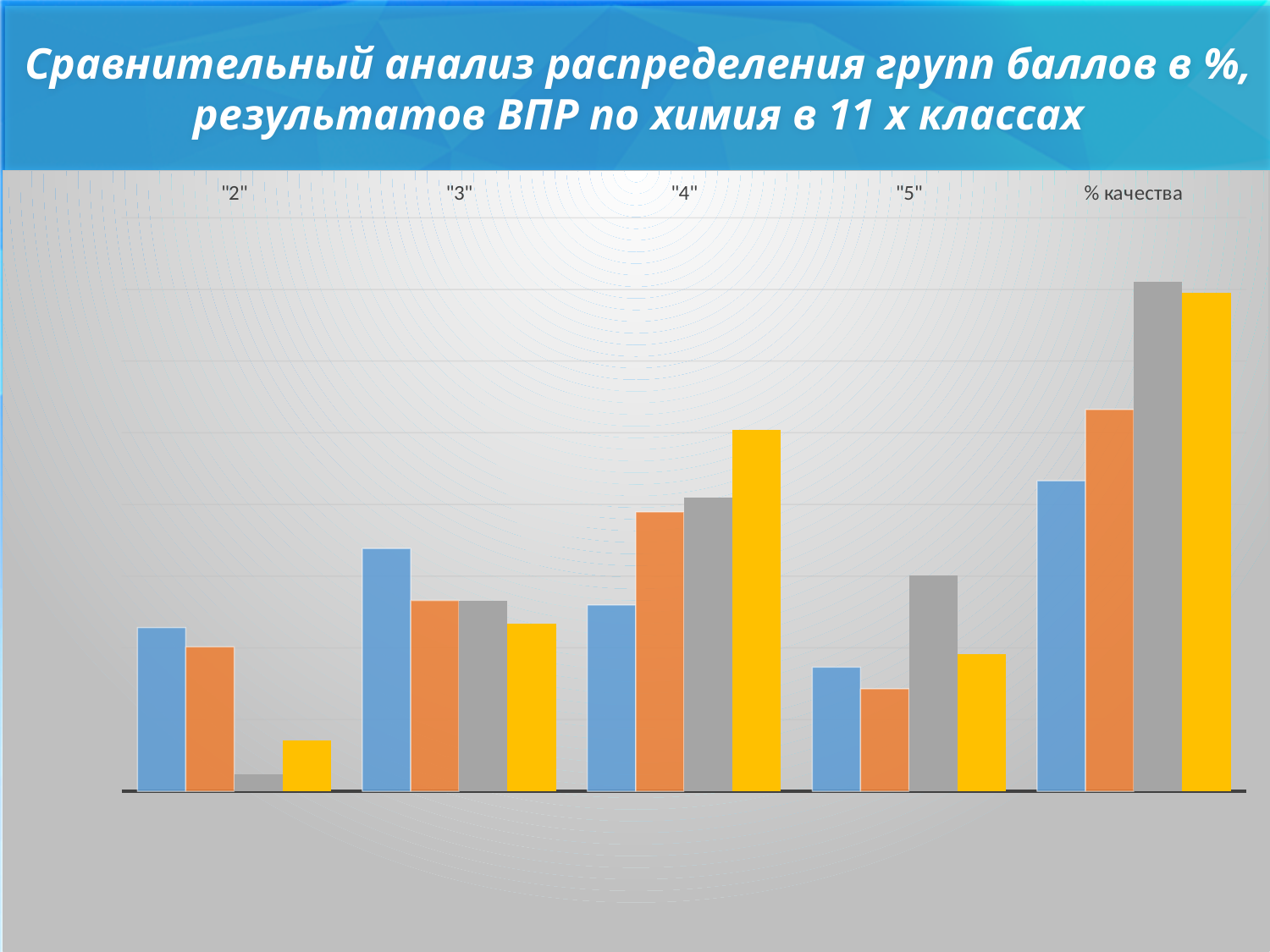
In the "2" category, which coloured bar is the shortest? gray In the "4" category, is the yellow bar or the blue bar taller? yellow Which category contains the tallest bar in the chart? % качества What is the title of the slide containing the chart? Сравнительный анализ распределения групп баллов в %, результатов ВПР по химия в 11 х классах What kind of chart is shown on the slide? bar chart In the "2" category, which coloured bar is the tallest? blue How many bars are plotted in each category group of the chart? 4 In the "5" category, which coloured bar is the tallest? gray Which category contains the shortest bar in the chart? "2" How many categories are shown along the x axis of the chart? 5 In the "% качества" category, which coloured bar is the shortest? blue For the blue bars, is the value in category "3" or category "4" larger? "3"